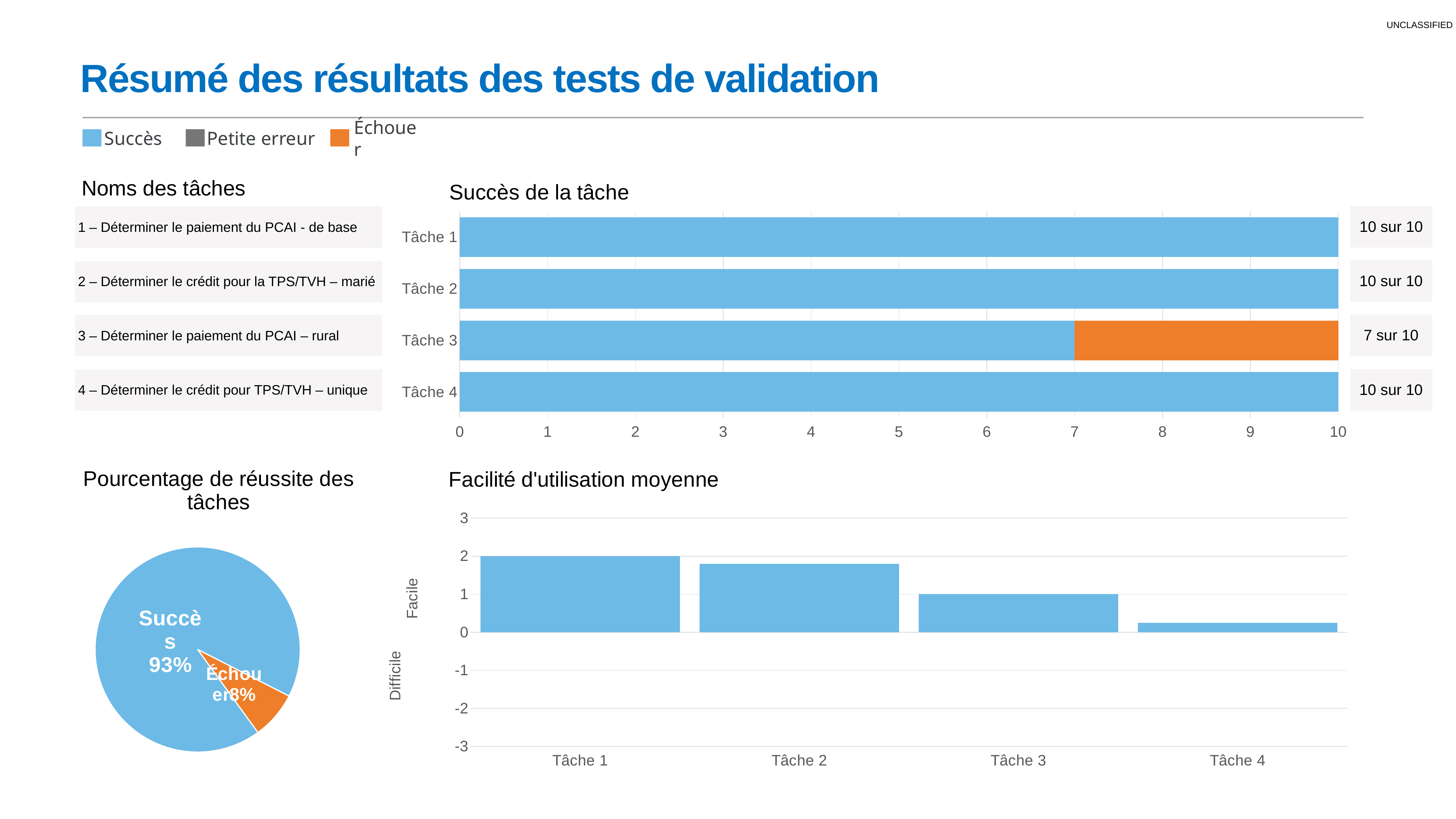
In the 'Pourcentage de réussite des tâches' pie chart, what share is labelled Succès? 93% In the 'Facilité d'utilisation moyenne' chart, which task has the lowest value? Tâche 4 In the 'Succès de la tâche' chart, which task has an orange 'Échouer' segment? Tâche 3 In the 'Succès de la tâche' chart, how many tasks are plotted? 4 In the 'Facilité d'utilisation moyenne' chart, is the value for Tâche 2 greater or less than 1? greater In the 'Pourcentage de réussite des tâches' pie chart, what share is labelled Échouer? 8% In the 'Succès de la tâche' chart, what is the label shown for Tâche 1? 10 sur 10 In the 'Facilité d'utilisation moyenne' chart, which task has the highest value? Tâche 1 In the 'Succès de la tâche' chart, which task has the lowest number of successes? Tâche 3 In the 'Succès de la tâche' chart, what is the label shown for Tâche 3? 7 sur 10 How many series does the legend at the top of the slide list? 3 What kind of chart is 'Pourcentage de réussite des tâches'? Pie chart